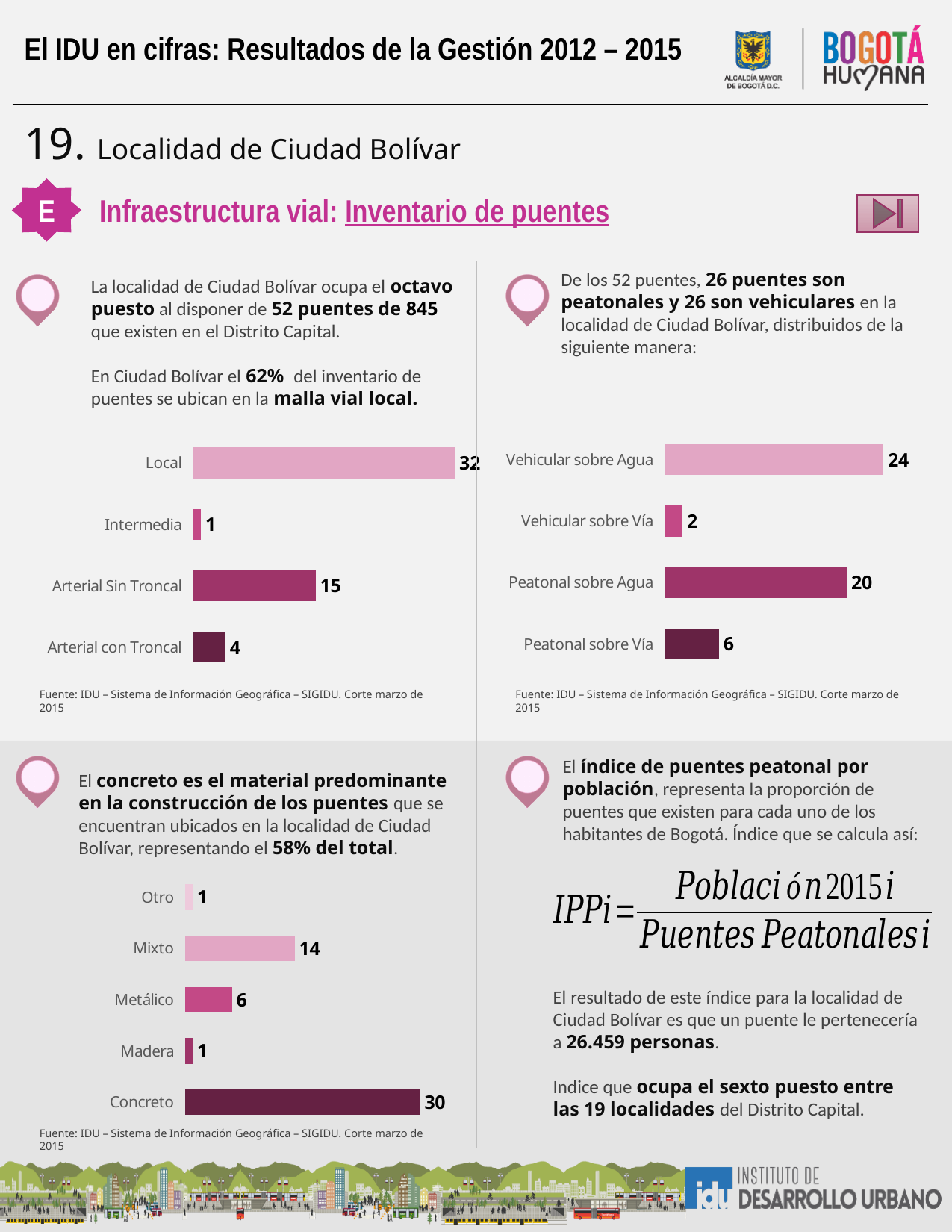
In the top-right bar chart, which is larger, Vehicular sobre Vía or Peatonal sobre Vía? Peatonal sobre Vía In the top-right bar chart, which category has the highest value? Vehicular sobre Agua In the bottom-left bar chart, which category has the highest value? Concreto In the top-left bar chart, what is the value for Arterial Sin Troncal? 15 In the bottom-left bar chart, what is the value for Mixto? 14 In the top-right bar chart, what is the value for Peatonal sobre Agua? 20 In the top-right bar chart, what is the difference between Vehicular sobre Agua and Peatonal sobre Agua? 4 In the bottom-left bar chart, how many categories are shown? 5 In the top-left bar chart, how many categories are shown? 4 In the top-left bar chart, which category has the lowest value? Intermedia What type of chart is the bottom-left chart? Bar chart In the top-left bar chart, what is the difference between Arterial Sin Troncal and Arterial con Troncal? 11